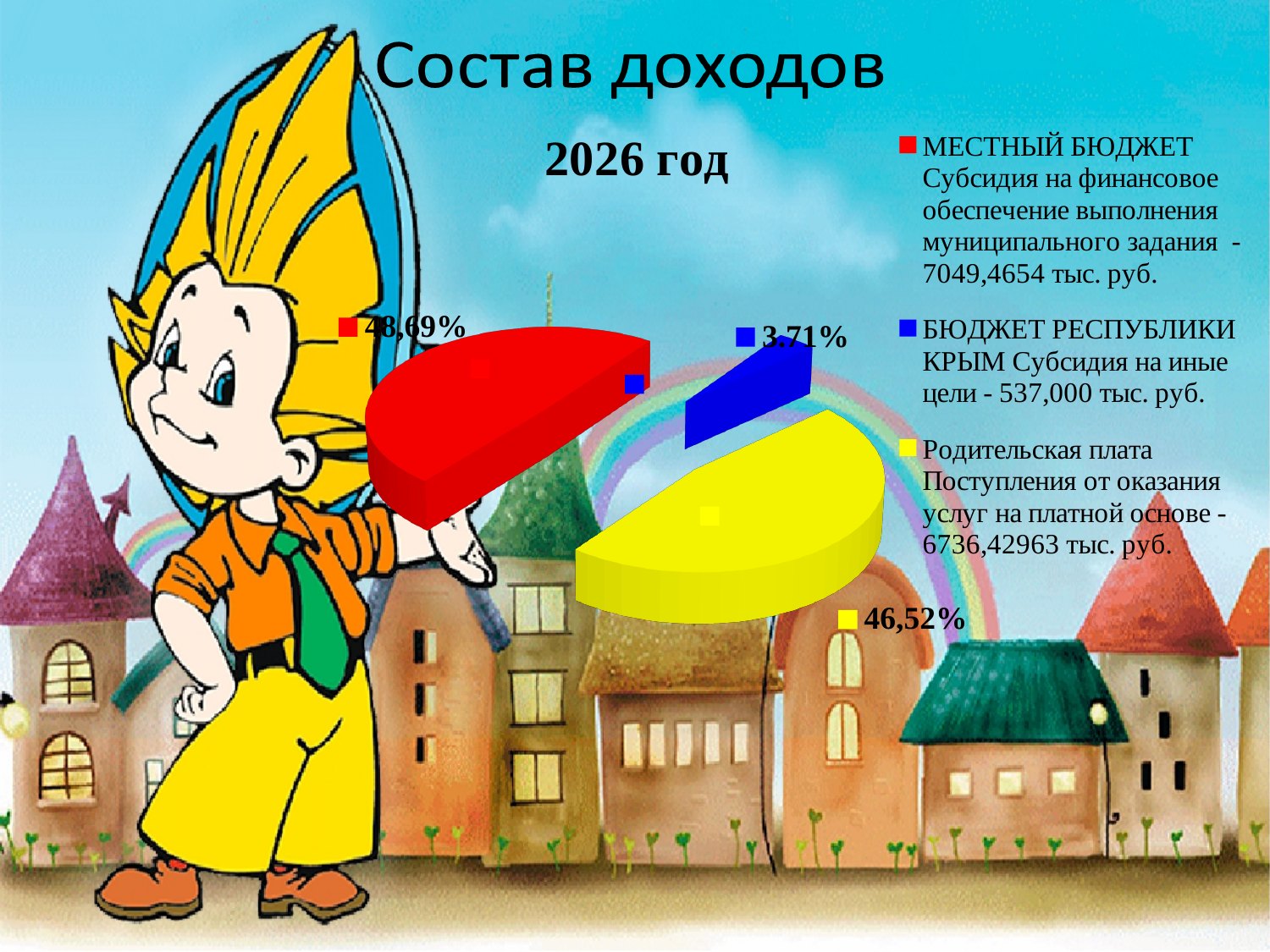
What share of the pie does МЕСТНЫЙ БЮДЖЕТ (red slice) have? 48,69% What kind of chart is shown on the slide? pie chart What share of the pie does БЮДЖЕТ РЕСПУБЛИКИ КРЫМ (blue slice) have? 3,71% According to the legend, what amount in тыс. руб. corresponds to БЮДЖЕТ РЕСПУБЛИКИ КРЫМ? 537,000 тыс. руб. What share of the pie does Родительская плата (yellow slice) have? 46,52% How many entries does the legend list? 3 Which slice of the pie is the largest? МЕСТНЫЙ БЮДЖЕТ What year is shown in the chart title? 2026 год Which slice of the pie is the smallest? БЮДЖЕТ РЕСПУБЛИКИ КРЫМ How many slices does the pie chart have? 3 Which is larger: the Родительская плата slice or the БЮДЖЕТ РЕСПУБЛИКИ КРЫМ slice? Родительская плата What is the difference in percentage points between the МЕСТНЫЙ БЮДЖЕТ slice and the Родительская плата slice? 2,17